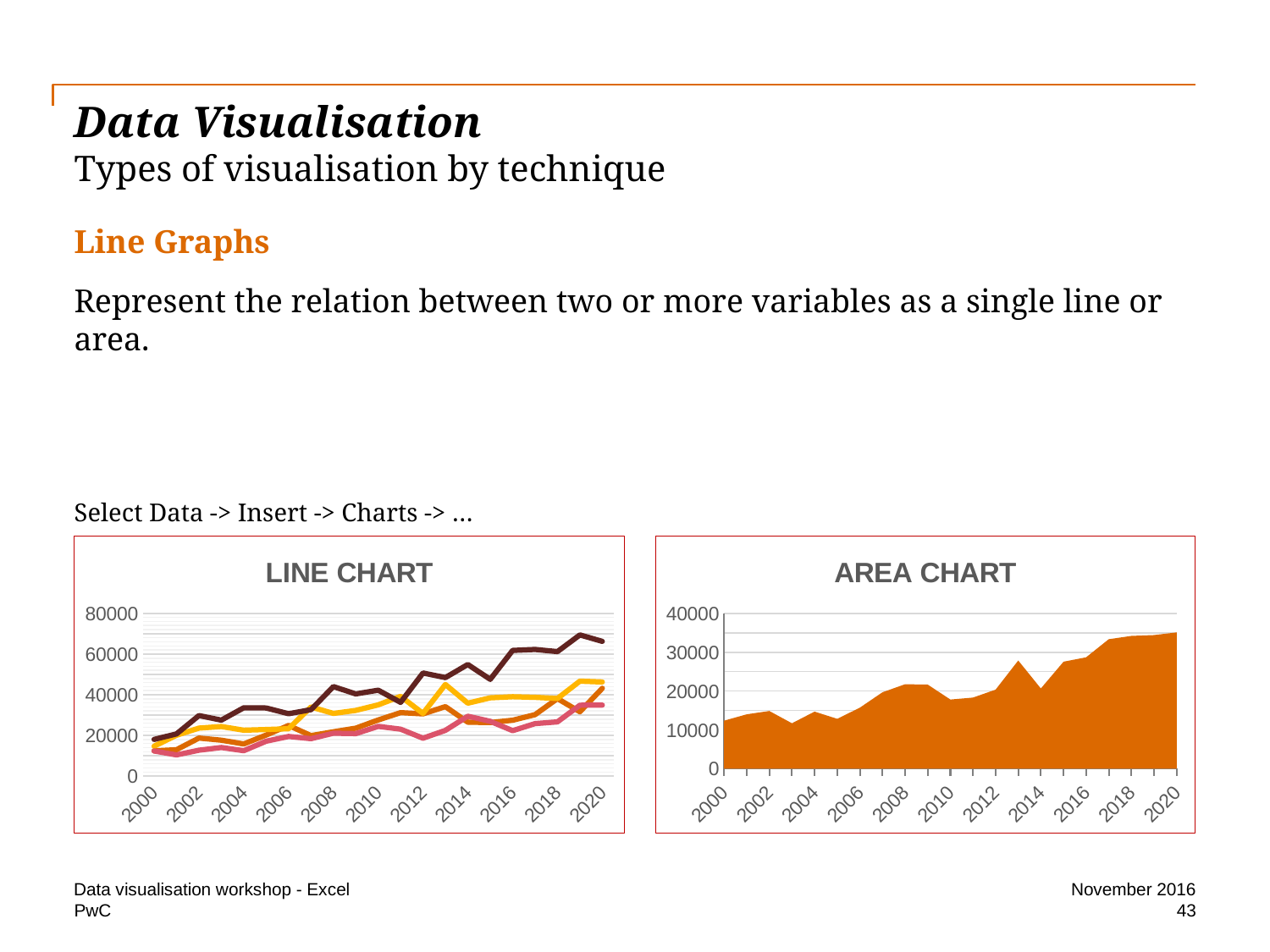
How many year labels are shown on the x axis of the AREA CHART? 11 What kind of chart is the chart on the left of the slide? line chart In the AREA CHART, do the values generally rise or fall from 2000 to 2020? rise What is the title of the chart on the left of the slide? LINE CHART In the AREA CHART, is the value for 2016 greater or less than 30000? less What kind of chart is the chart on the right of the slide? area chart In the AREA CHART, is the value for 2020 greater or less than 30000? greater In the AREA CHART, is the value for 2018 greater or less than 30000? greater In the AREA CHART, which year has the larger value, 2000 or 2020? 2020 What is the title of the chart on the right of the slide? AREA CHART